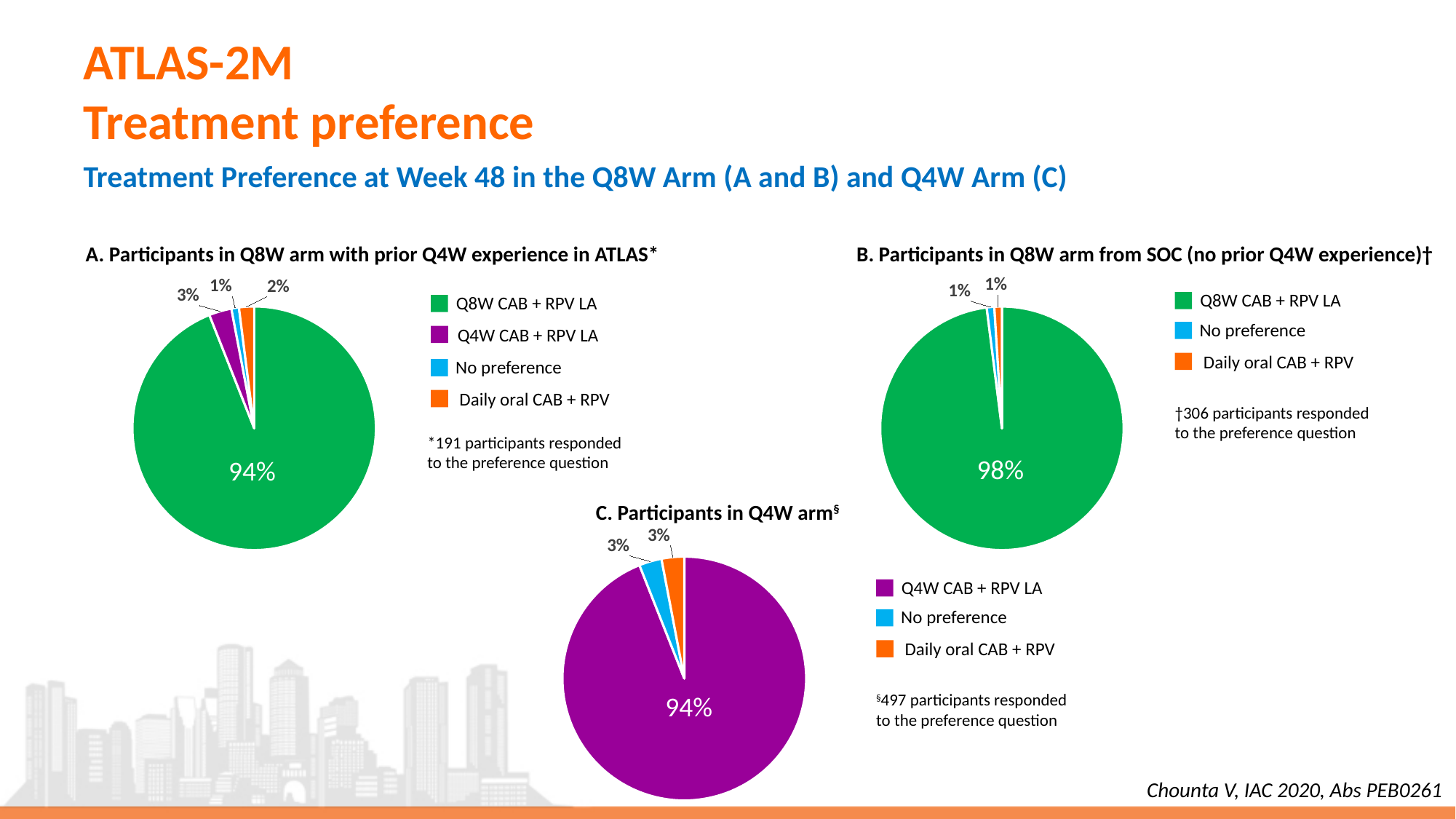
In chart A (Participants in Q8W arm with prior Q4W experience in ATLAS), what is the difference between the Q4W CAB + RPV LA share and the Daily oral CAB + RPV share? 1% In chart A (Participants in Q8W arm with prior Q4W experience in ATLAS), what share of participants preferred Daily oral CAB + RPV? 2% In chart C (Participants in Q4W arm), what share of participants preferred Q4W CAB + RPV LA? 94% What type of chart is chart B (Participants in Q8W arm from SOC)? Pie chart In chart C (Participants in Q4W arm), what share of participants had no preference? 3% How many categories does the legend of chart C (Participants in Q4W arm) list? 3 How many categories does the legend of chart A (Participants in Q8W arm with prior Q4W experience in ATLAS) list? 4 In chart A (Participants in Q8W arm with prior Q4W experience in ATLAS), which option has the smallest share? No preference